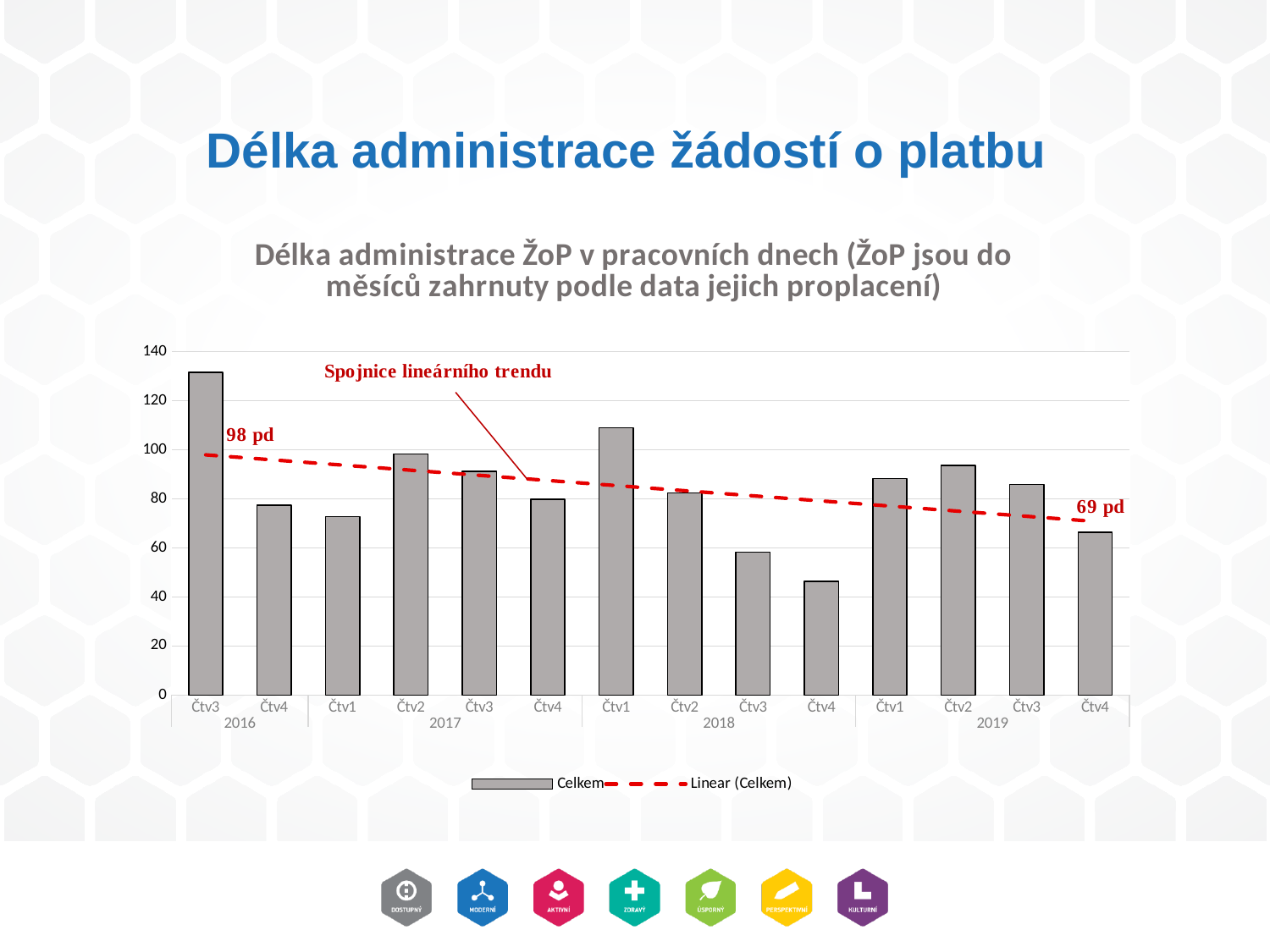
What value is labelled at the end of the linear trend line? 69 pd Which quarter has the lowest bar? Čtv4 2018 Which quarter has the highest bar? Čtv3 2016 Is the value for Čtv4 2018 greater or less than 60? less Is the value for Čtv1 2018 greater or less than 100? greater What kind of chart is shown on the slide? bar chart How many bars (quarters) are plotted in the chart? 14 Which is larger, the value for Čtv1 2018 or the value for Čtv3 2018? Čtv1 2018 Is the value for Čtv3 2016 greater or less than 120? greater What value is labelled at the start of the linear trend line? 98 pd Does the linear trend line rise or fall from left to right? fall How many series does the legend list? 2